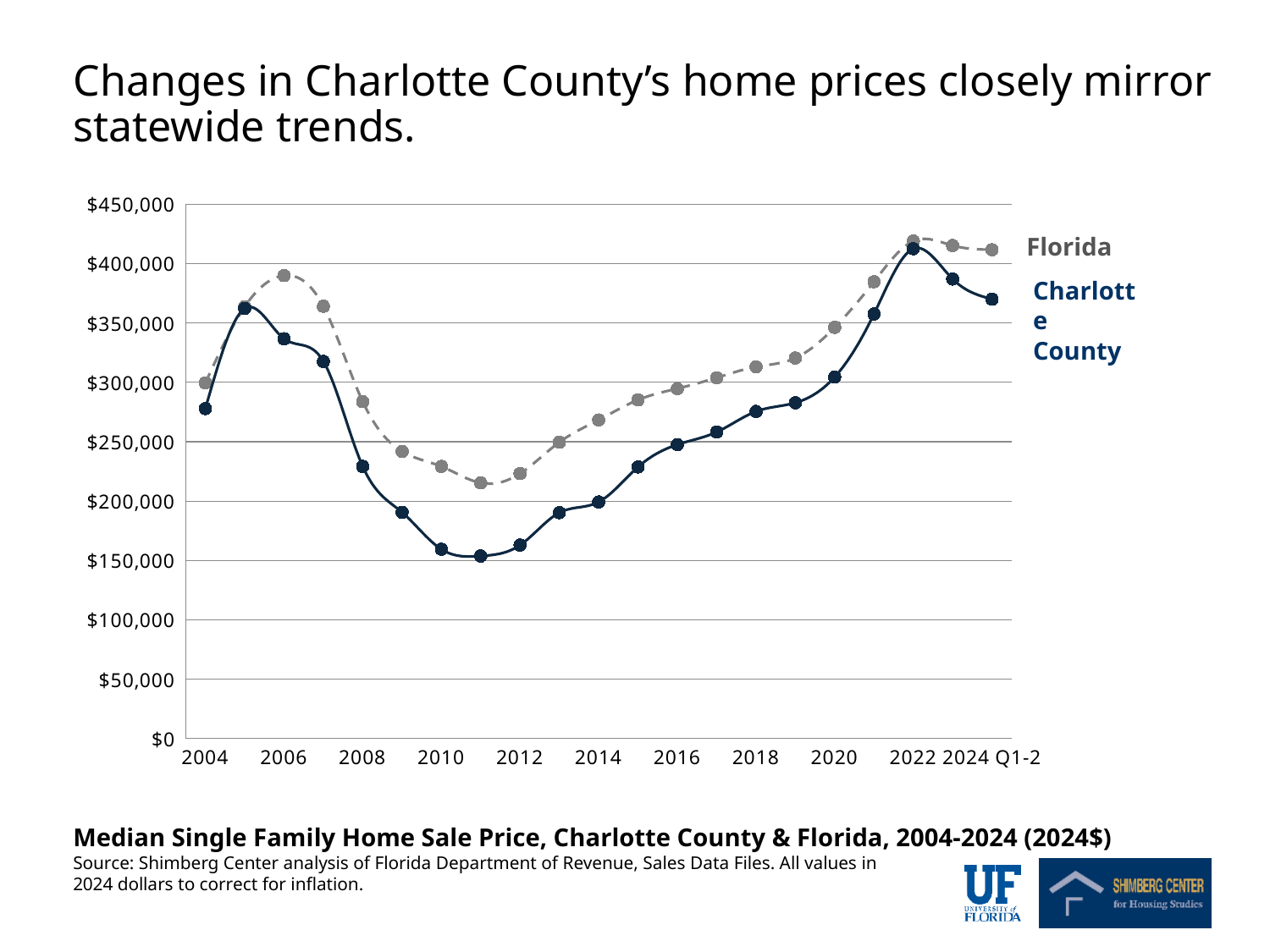
Is the Charlotte County value for 2022 greater or less than $400,000? greater In which year does the Charlotte County series reach its lowest value? 2011 How many series does the chart show? 2 Is the Charlotte County value for 2011 greater or less than $200,000? less In which year does the Florida series reach its highest value? 2022 Do Charlotte County home prices rise or fall between 2011 and 2022? rise Is the Florida value for 2006 greater or less than $350,000? greater What are the two series plotted on the chart? Florida and Charlotte County In which year does the Charlotte County series reach its highest value? 2022 What is the title of the chart? Median Single Family Home Sale Price, Charlotte County & Florida, 2004-2024 (2024$) What kind of chart is shown on the slide? line chart In 2010, which series has the higher value, Florida or Charlotte County? Florida